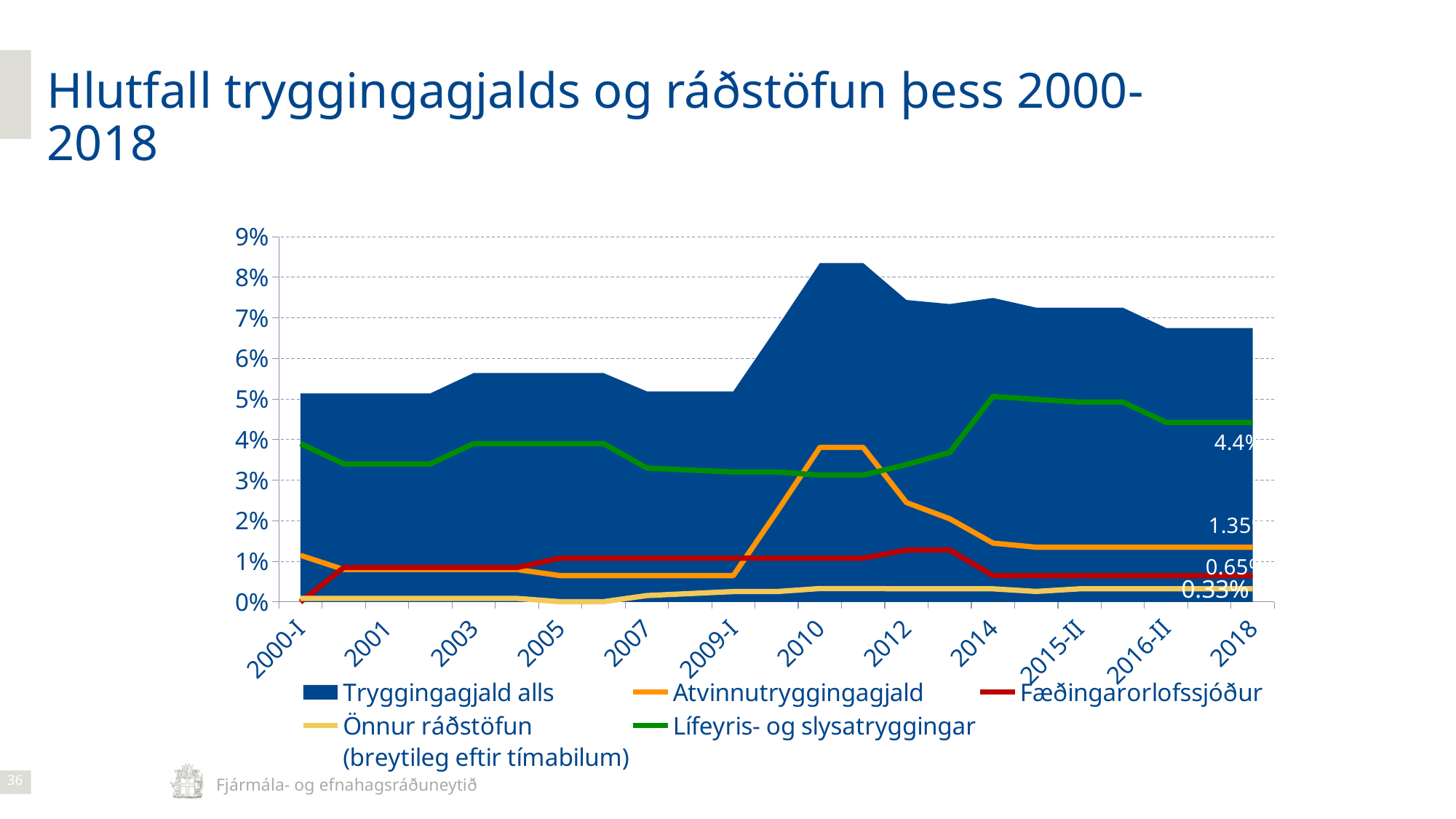
What is the value of Lífeyris- og slysatryggingar in 2018? 4.4% How many series does the legend list? 5 What colour is the Lífeyris- og slysatryggingar line? green In 2018, which is larger: Lífeyris- og slysatryggingar or Önnur ráðstöfun? Lífeyris- og slysatryggingar Is the value of Tryggingagjald alls in 2010 greater or less than 8%? greater What is the value of Önnur ráðstöfun (breytileg eftir tímabilum) in 2018? 0.33% Is the value of Lífeyris- og slysatryggingar in 2014 greater or less than 4%? greater Is the value of Atvinnutryggingagjald in 2010 greater or less than 3%? greater In which year does Tryggingagjald alls reach its highest value? 2010 How many category labels are shown on the x axis? 12 What is the value of Fæðingarorlofssjóður in 2018? 0.65% Does Atvinnutryggingagjald rise or fall between 2012 and 2018? fall